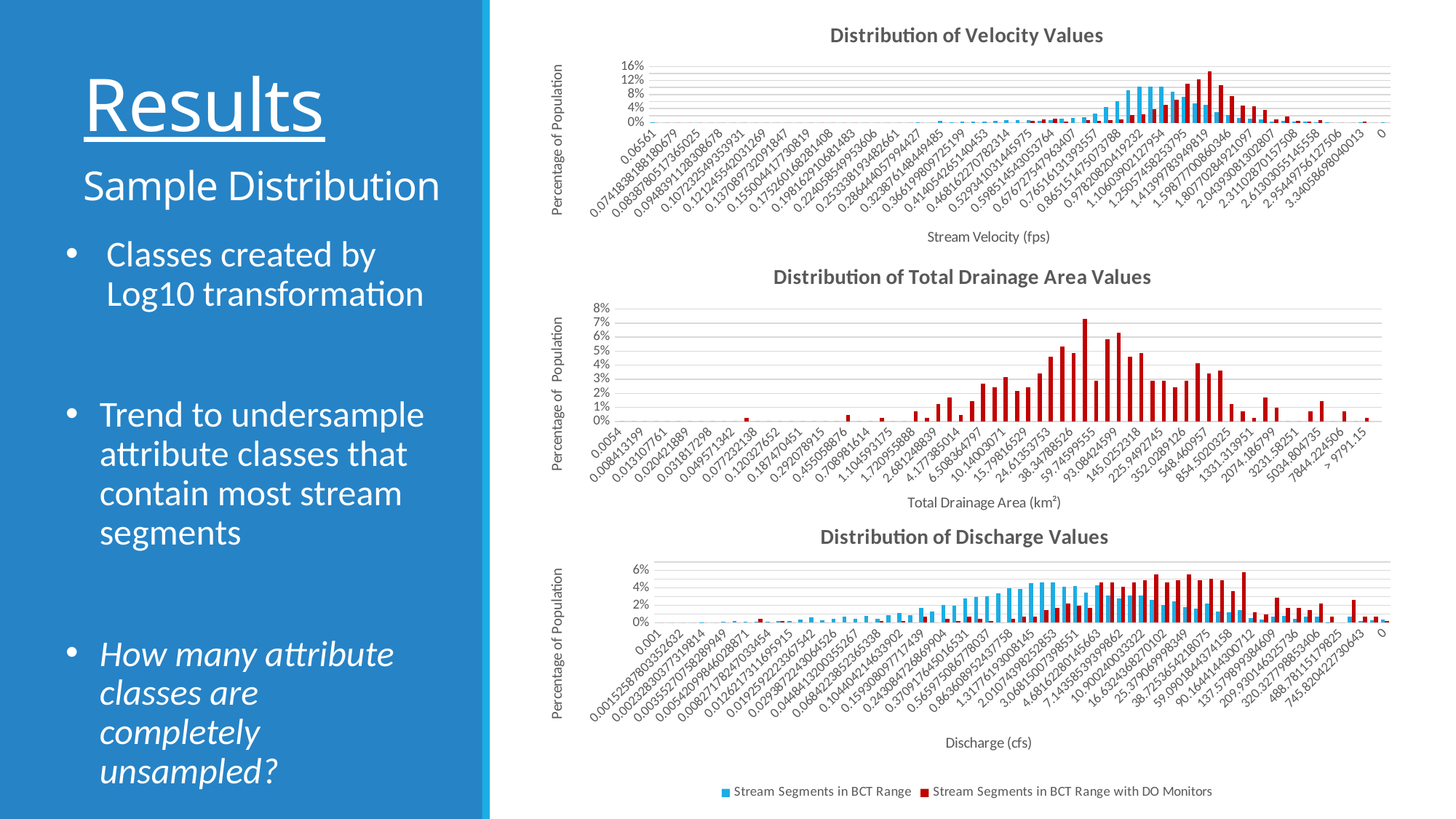
Which series does the red colour represent in the legend? Stream Segments in BCT Range with DO Monitors How many series does the legend at the bottom of the slide list? 2 In the 'Distribution of Velocity Values' chart, which is taller: the tallest blue bar or the tallest red bar? the tallest red bar In the 'Distribution of Total Drainage Area Values' chart, is the tallest bar greater or less than 6%? greater In the 'Distribution of Discharge Values' chart, is the tallest red bar greater or less than 4%? greater What is the x-axis title of the 'Distribution of Total Drainage Area Values' chart? Total Drainage Area (km²) In the 'Distribution of Discharge Values' chart, which is taller: the tallest blue bar or the tallest red bar? the tallest red bar What kind of chart is the 'Distribution of Velocity Values' chart? bar chart In the 'Distribution of Velocity Values' chart, is the tallest blue bar greater or less than 8%? greater How many charts are shown on the slide? 3